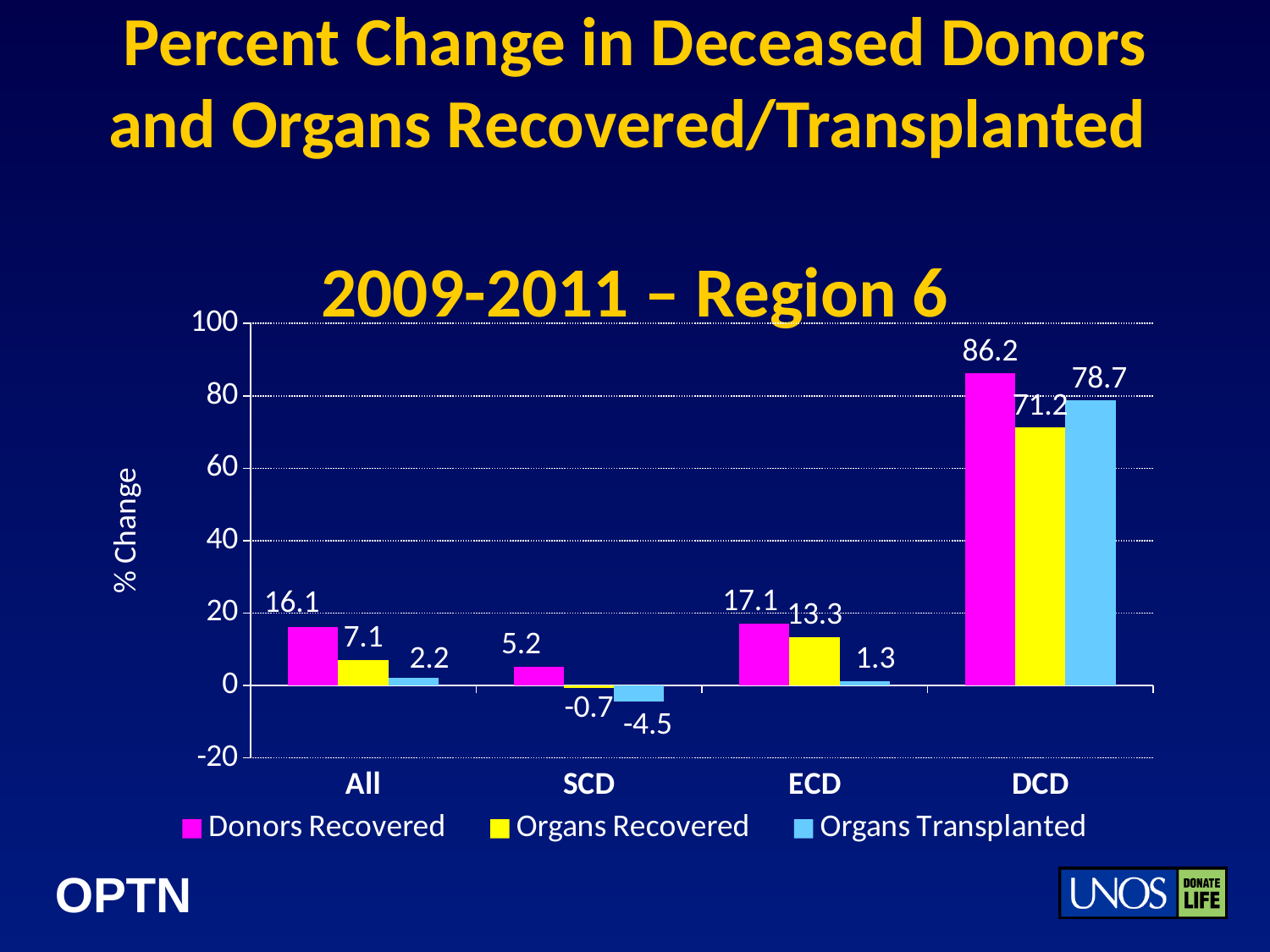
What kind of chart is shown on the slide? Bar chart Which is larger in the All category: Donors Recovered or Organs Recovered? Donors Recovered What is the label of the y axis? % Change Which series is shown in yellow? Organs Recovered How many categories are shown on the x axis? 4 Which category has the lowest value for Organs Transplanted? SCD Which category has the highest value for Donors Recovered? DCD What is the value for Donors Recovered in the DCD category? 86.2 What is the value for Organs Transplanted in the SCD category? -4.5 How many series does the legend list? 3 What is the value for Organs Recovered in the ECD category? 13.3 What is the difference between Donors Recovered and Organs Recovered in the DCD category? 15